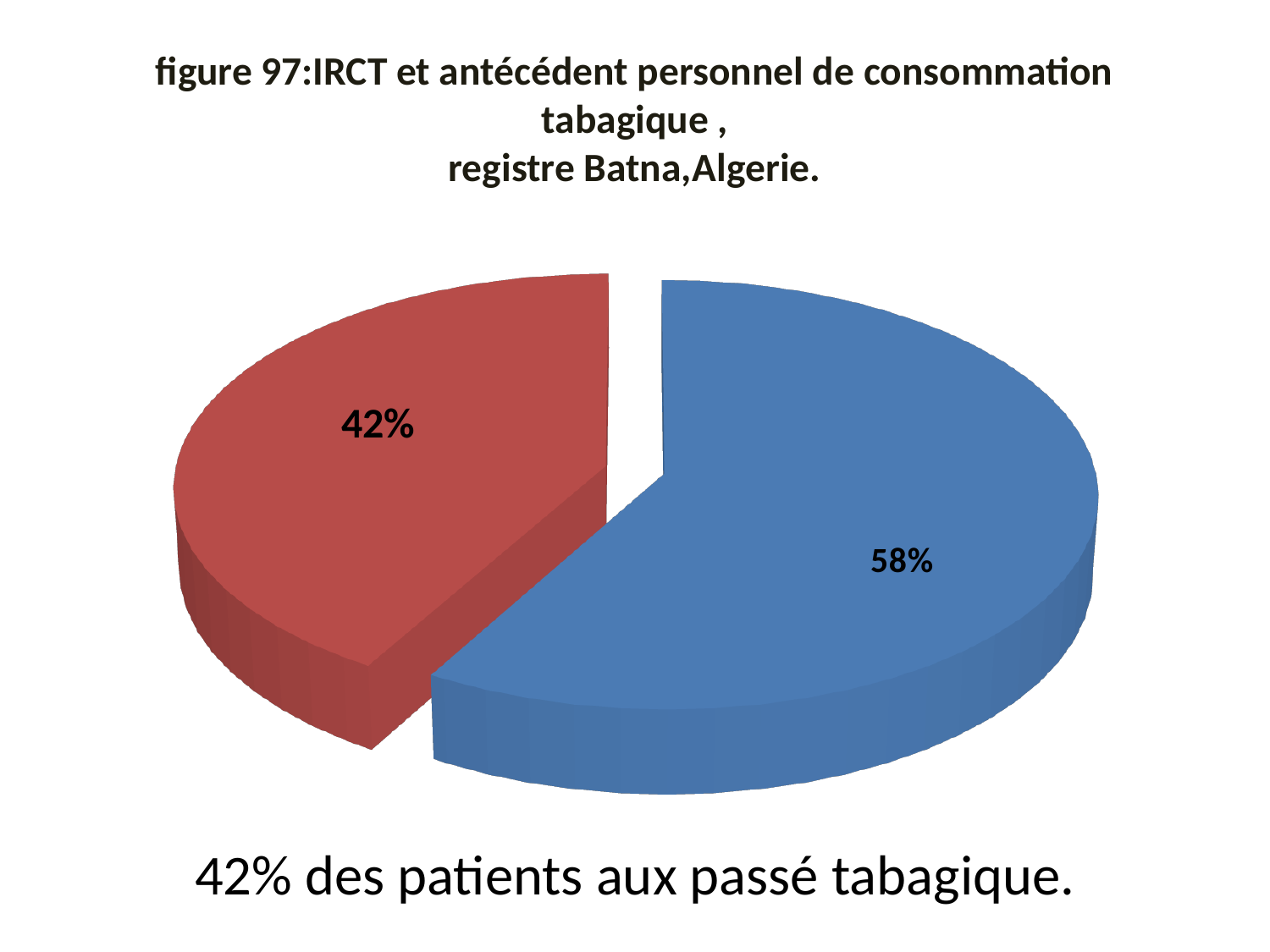
According to the slide, what percentage of patients have a history of tobacco consumption (passé tabagique)? 42% What is the difference in percentage points between the blue slice and the red slice? 16 percentage points Is the blue slice greater or less than 50% of the pie? greater What is the figure number given in the chart title? figure 97 Which slice of the pie chart is the smallest? the red slice (42%) What percentage is shown on the red slice of the pie chart? 42% Which is larger, the blue slice or the red slice? the blue slice What share of the pie does the red slice represent? 42% What percentage is shown on the blue slice of the pie chart? 58% Which slice of the pie chart is the largest? the blue slice (58%) What kind of chart is shown on the slide? pie chart How many slices does the pie chart have? 2